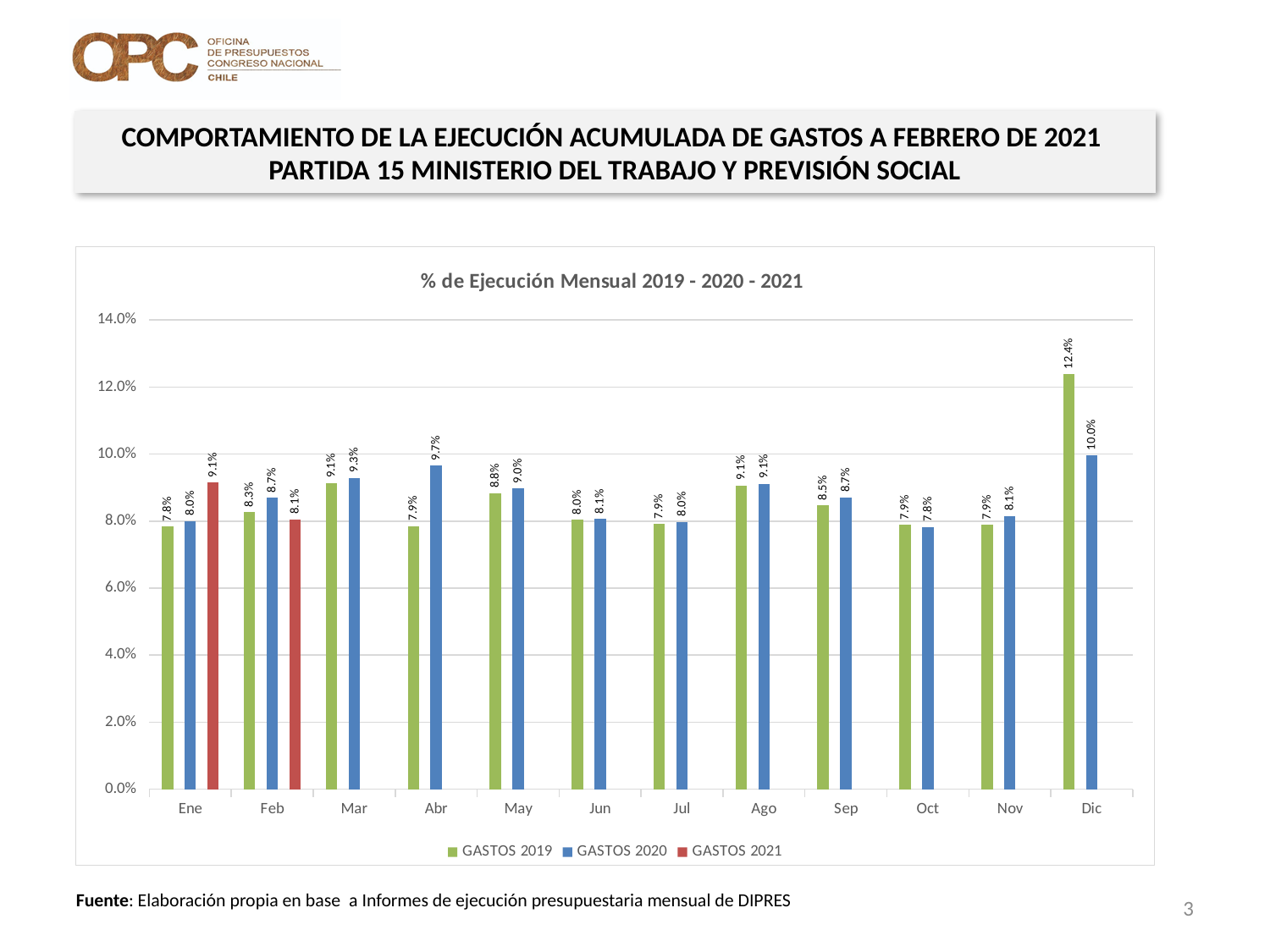
Which is larger in Feb, GASTOS 2020 or GASTOS 2021? GASTOS 2020 What is the difference between GASTOS 2019 and GASTOS 2020 in Dic? 2.4% What is the value for GASTOS 2021 in Ene? 9.1% In which month is the GASTOS 2019 value highest? Dic What is the value for GASTOS 2019 in Dic? 12.4% What kind of chart is shown on the slide? Bar chart How many series does the legend list? 3 In which month is the GASTOS 2020 value lowest? Oct What is the value for GASTOS 2020 in Abr? 9.7% What is the title of the chart? % de Ejecución Mensual 2019 - 2020 - 2021 What is the value for GASTOS 2021 in Feb? 8.1% How many months are shown on the x axis? 12